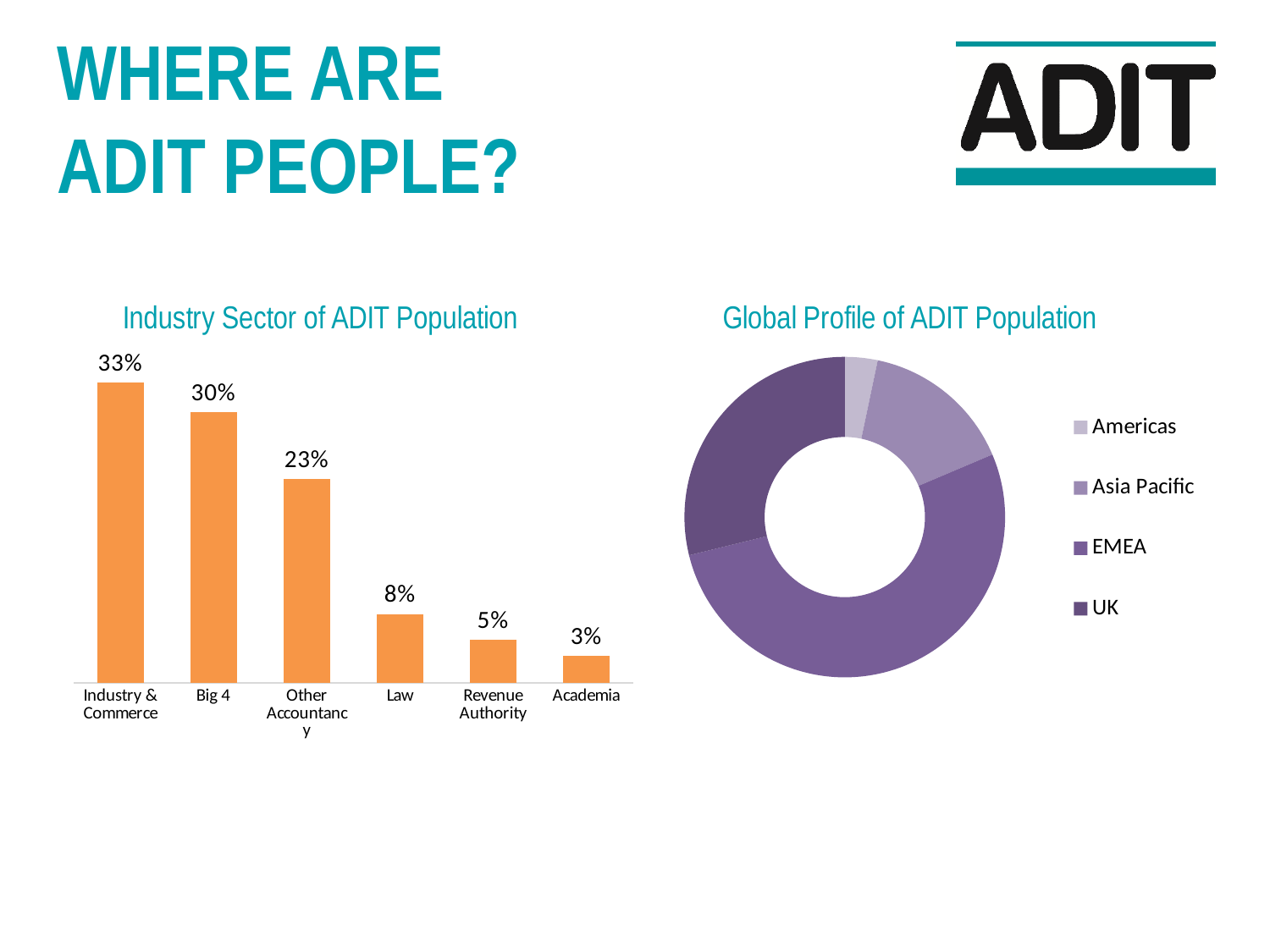
How many sectors are shown in the Industry Sector of ADIT Population chart? 6 In the Industry Sector of ADIT Population chart, which is larger, Law or Revenue Authority? Law In the Industry Sector of ADIT Population chart, what is the difference between Industry & Commerce and Other Accountancy? 10% In the Industry Sector of ADIT Population chart, what is the value for Law? 8% What kind of chart is the Industry Sector of ADIT Population chart? Bar chart In the Industry Sector of ADIT Population chart, what is the value for Revenue Authority? 5% In the Industry Sector of ADIT Population chart, what is the value for Big 4? 30% In the Global Profile of ADIT Population chart, which region has the largest share? EMEA In the Industry Sector of ADIT Population chart, which sector has the highest value? Industry & Commerce In the Industry Sector of ADIT Population chart, which sector has the lowest value? Academia How many regions does the legend of the Global Profile of ADIT Population chart list? 4 In the Global Profile of ADIT Population chart, which region has the smallest share? Americas